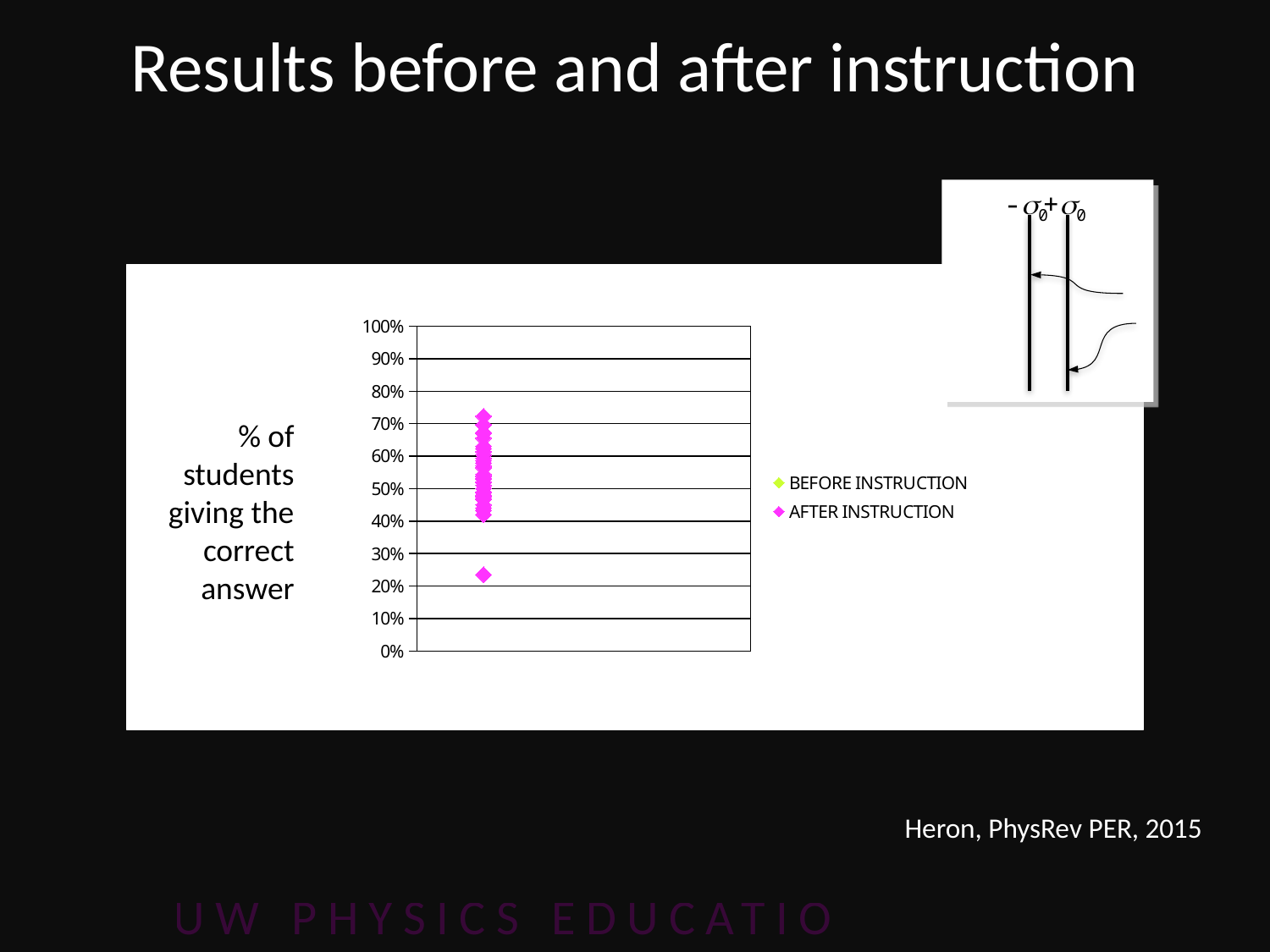
Is the highest plotted point on the chart greater or less than 80%? less What is the highest value shown on the chart's vertical axis? 100% How many series does the chart legend list? 2 What kind of chart is shown on the slide? scatter chart What are the two series named in the chart legend? BEFORE INSTRUCTION and AFTER INSTRUCTION Is the lowest plotted point on the chart greater or less than 30%? less Is the lowest plotted point on the chart greater or less than 20%? greater